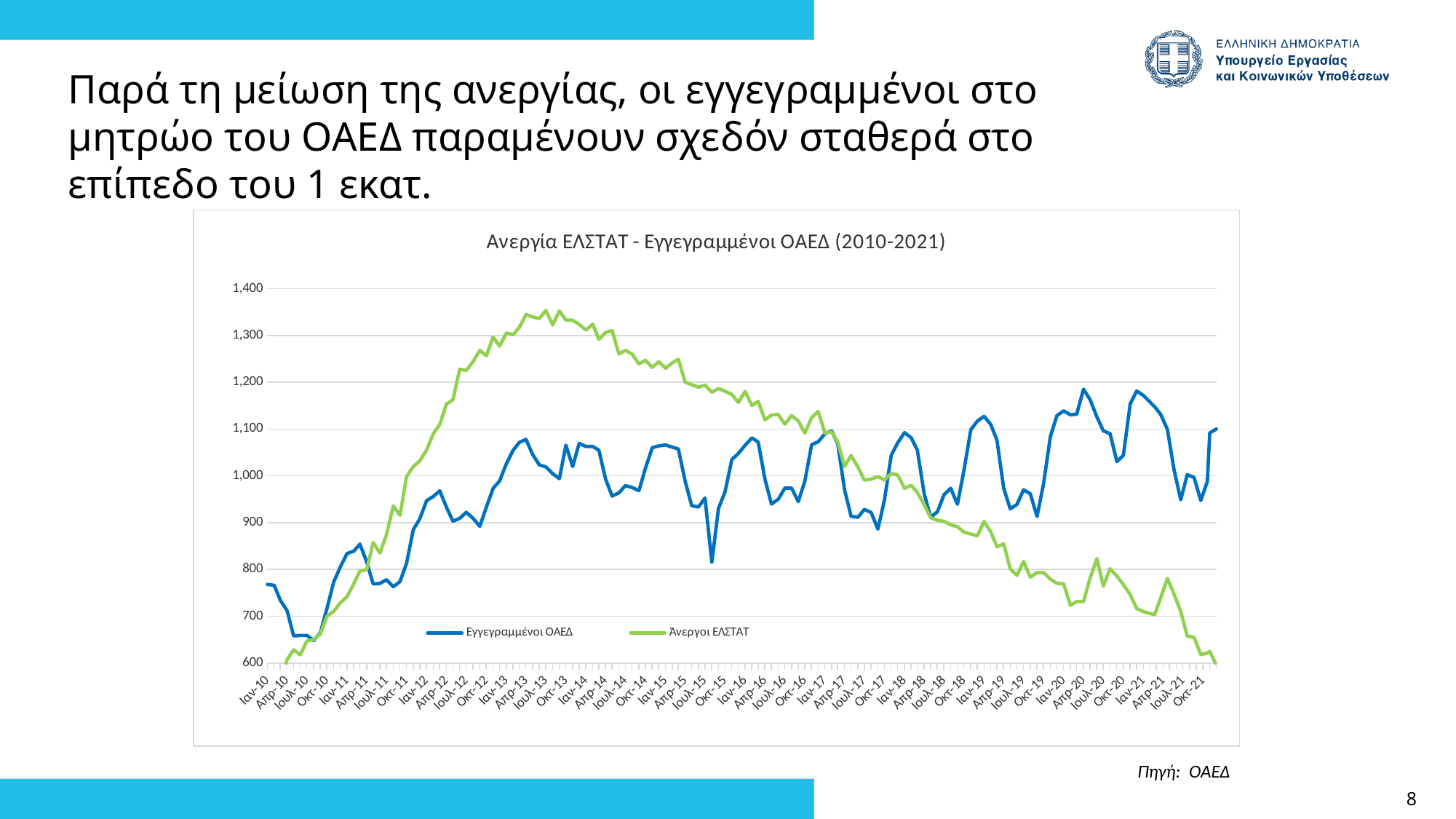
Which series reaches the highest value anywhere on the chart? Άνεργοι ΕΛΣΤΑΤ At Οκτ-21, which series has the larger value, Εγγεγραμμένοι ΟΑΕΔ or Άνεργοι ΕΛΣΤΑΤ? Εγγεγραμμένοι ΟΑΕΔ Which series is drawn in green in the chart? Άνεργοι ΕΛΣΤΑΤ Is the value of Εγγεγραμμένοι ΟΑΕΔ at Απρ-20 greater or less than 1,100? greater Is the value of Άνεργοι ΕΛΣΤΑΤ at Οκτ-21 greater or less than 700? less Is the value of Εγγεγραμμένοι ΟΑΕΔ at Ιαν-10 greater or less than 800? less What kind of chart is shown on the slide? Line chart At Ιαν-13, which series has the larger value, Εγγεγραμμένοι ΟΑΕΔ or Άνεργοι ΕΛΣΤΑΤ? Άνεργοι ΕΛΣΤΑΤ How many series does the chart's legend list? 2 Does the Άνεργοι ΕΛΣΤΑΤ line rise or fall between Ιουλ-13 and Οκτ-21? Fall What is the title of the chart? Ανεργία ΕΛΣΤΑΤ - Εγγεγραμμένοι ΟΑΕΔ (2010-2021)